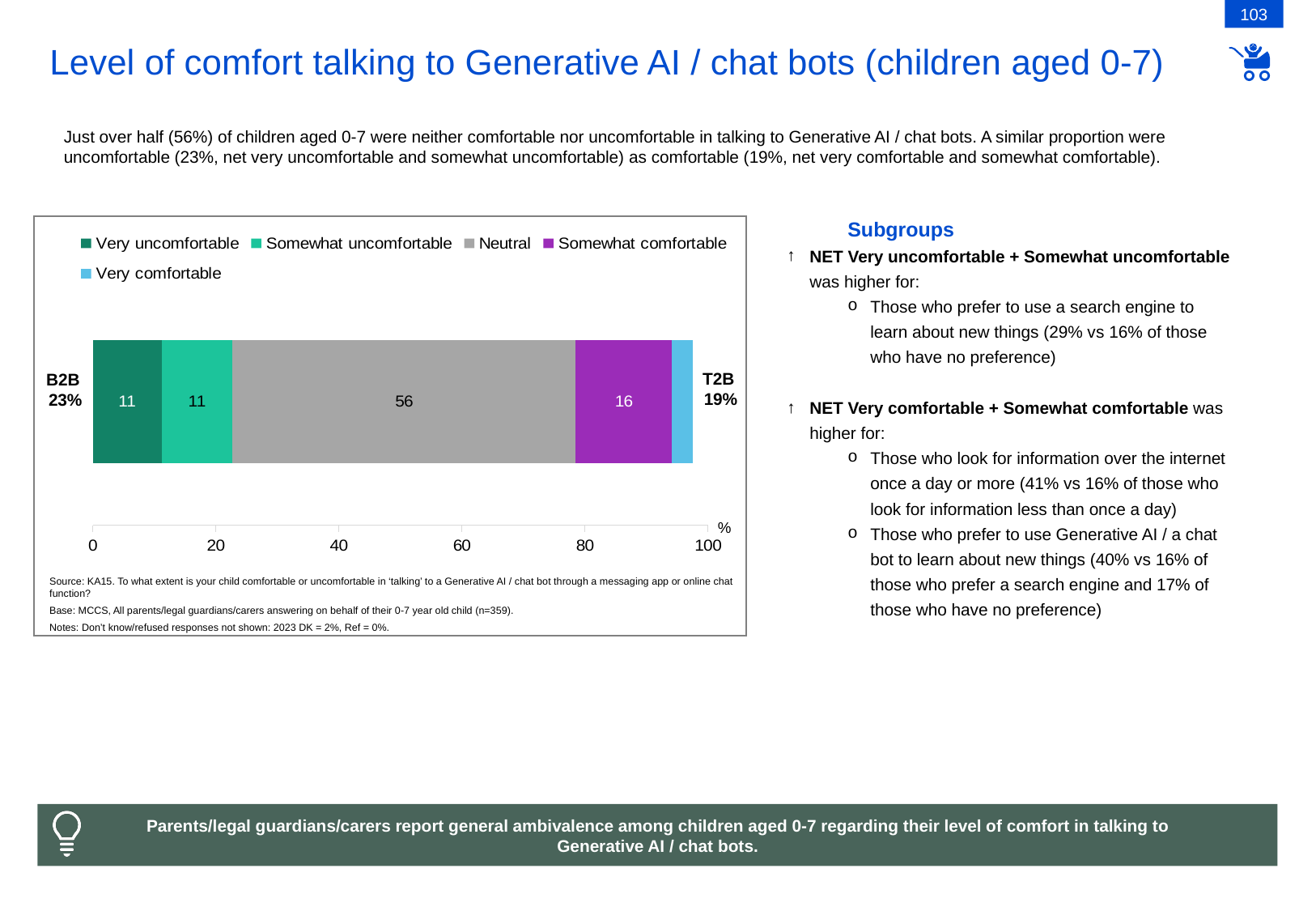
What is the difference between the Neutral value and the Somewhat comfortable value? 40 What kind of chart is shown on the slide? Stacked bar chart What is the value for the Neutral segment of the bar? 56 Which response category has the largest segment in the bar? Neutral What B2B percentage is shown to the left of the bar? 23% What is the value for the Very uncomfortable segment? 11 Which response category has the smallest segment in the bar? Very comfortable How many series does the legend list? 5 What is the value for the Somewhat uncomfortable segment? 11 What T2B percentage is shown to the right of the bar? 19% What is the value for the Somewhat comfortable segment? 16 Which is larger, the Somewhat comfortable segment or the Very uncomfortable segment? Somewhat comfortable